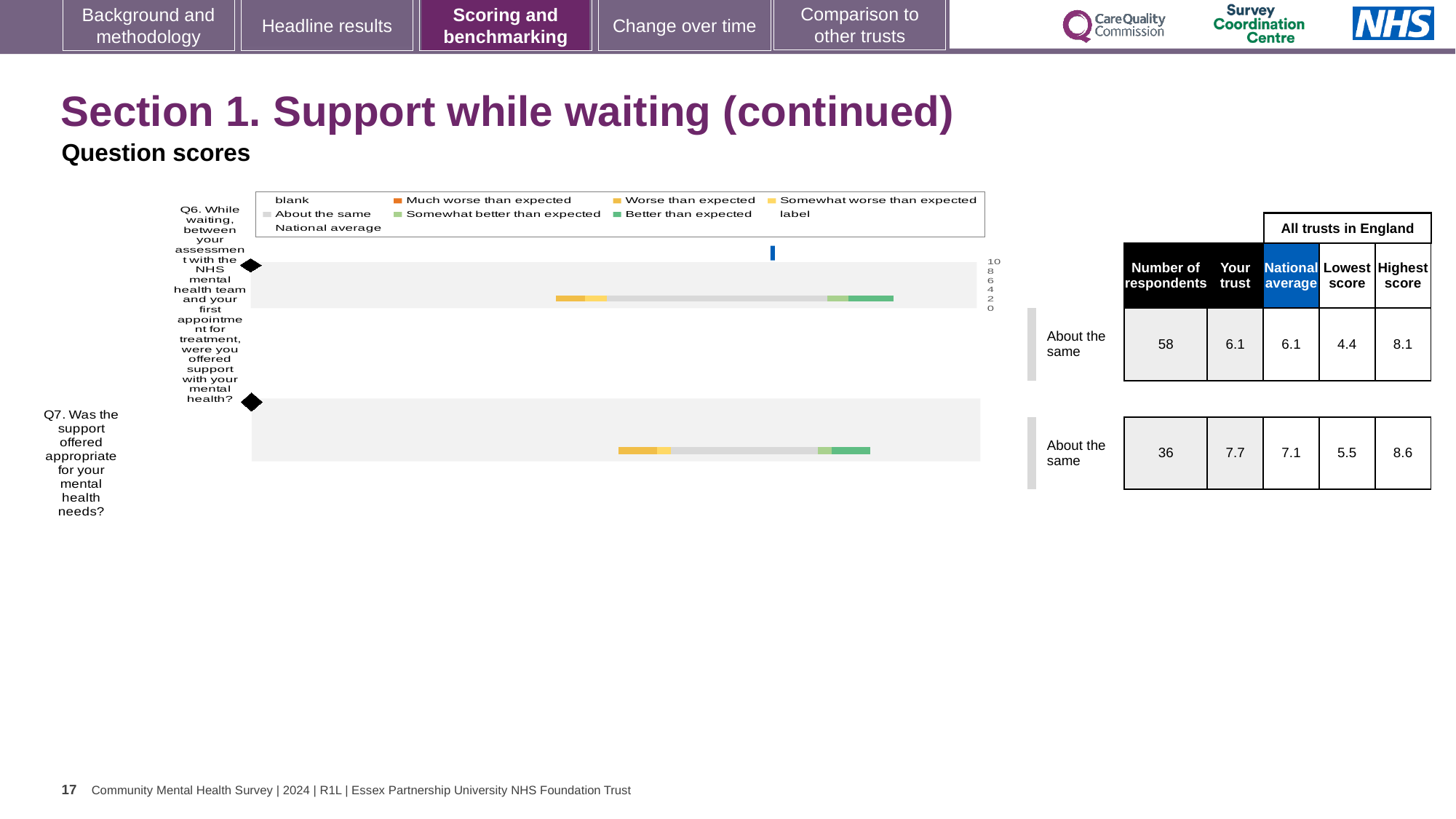
How many questions (categories) are plotted in the chart? 2 What is the lowest score among all trusts in England for Q6? 4.4 What is the national average score for Q7? 7.1 What benchmark category is shown for both Q6 and Q7? About the same Which question has the higher 'Your trust' score, Q6 or Q7? Q7 What kind of chart is shown on the slide? bar chart How many respondents answered Q6? 58 What is the 'Your trust' score for Q6 (support while waiting between assessment and first appointment)? 6.1 What is the highest score among all trusts in England for Q7? 8.6 What is the 'Your trust' score for Q7 (was the support offered appropriate for your mental health needs)? 7.7 What is the difference between the highest and lowest scores in England for Q6? 3.7 What is the difference between the trust's score and the national average for Q7? 0.6